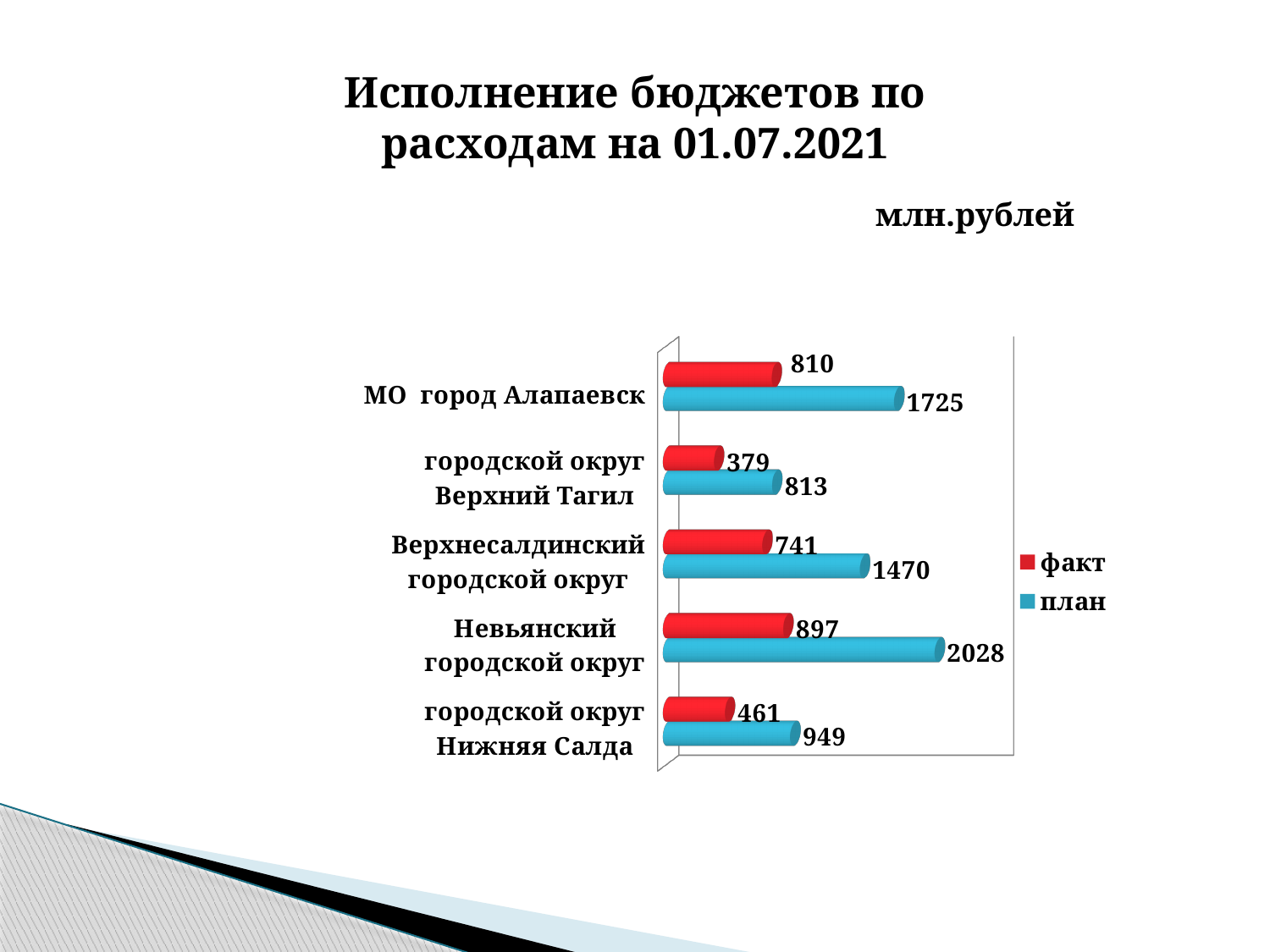
What is the план value for МО город Алапаевск? 1725 How many series does the legend list? 2 What is the план value for Невьянский городской округ? 2028 Which category has the lowest план value? городской округ Верхний Тагил What is the факт value for городской округ Верхний Тагил? 379 What unit is stated for the values on the slide? млн.рублей Which is larger: the факт value for МО город Алапаевск or the факт value for Верхнесалдинский городской округ? МО город Алапаевск What is the difference between план and факт for Верхнесалдинский городской округ? 729 Which colour represents the план series? blue Which category has the highest факт value? Невьянский городской округ How many categories are shown on the chart? 5 What kind of chart is shown on the slide? bar chart